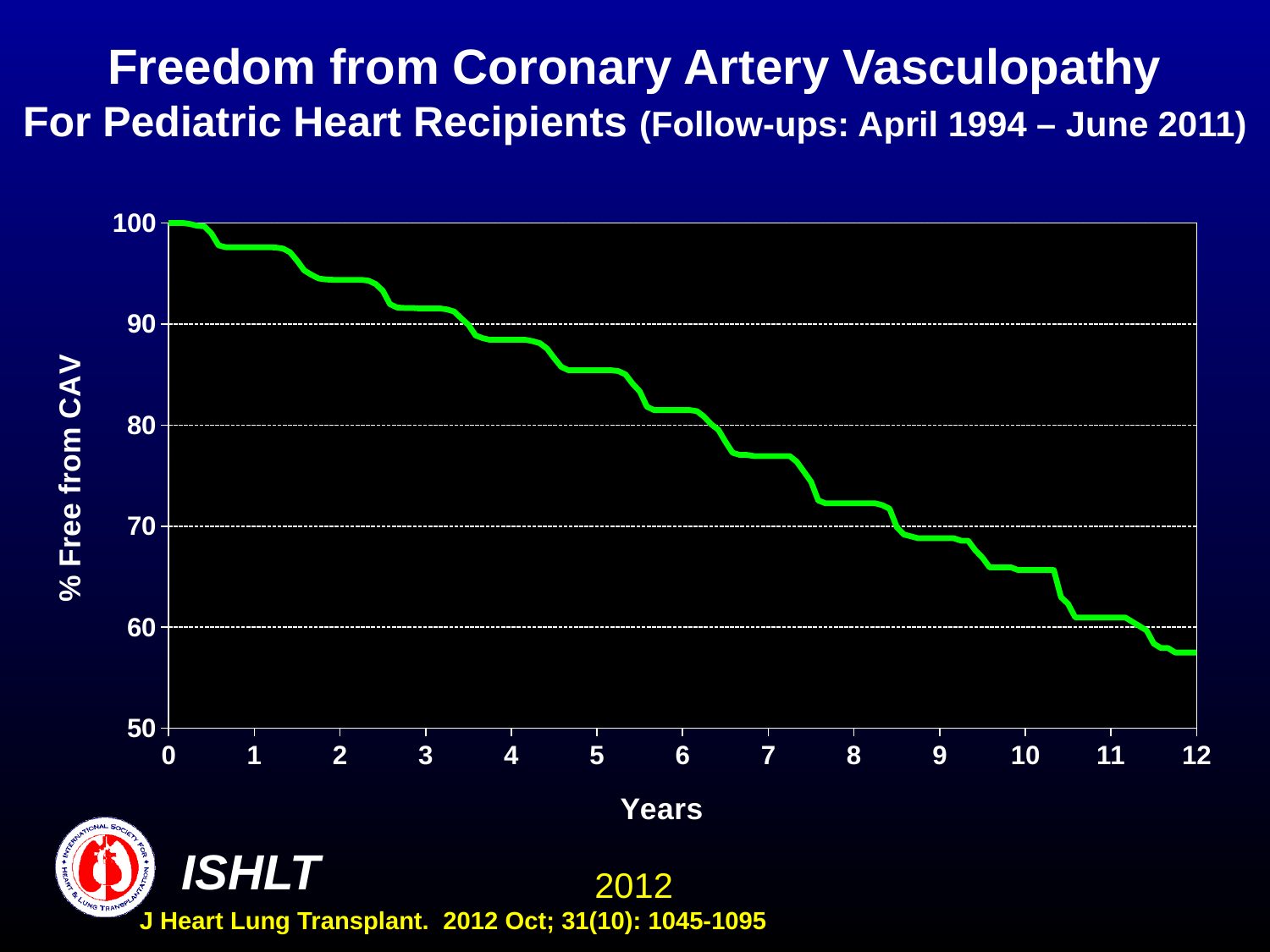
Is the value for % Free from CAV at year 4 greater or less than 90? less Is the value for % Free from CAV at year 12 greater or less than 60? less Is the value for % Free from CAV at year 7 greater or less than 80? less What is the label of the x axis? Years What is the value of % Free from CAV at year 0? 100 What is the label of the y axis? % Free from CAV What kind of chart is shown on the slide? line chart Do the values rise or fall as the years increase along the x axis? fall How many tick marks are labelled on the x axis? 13